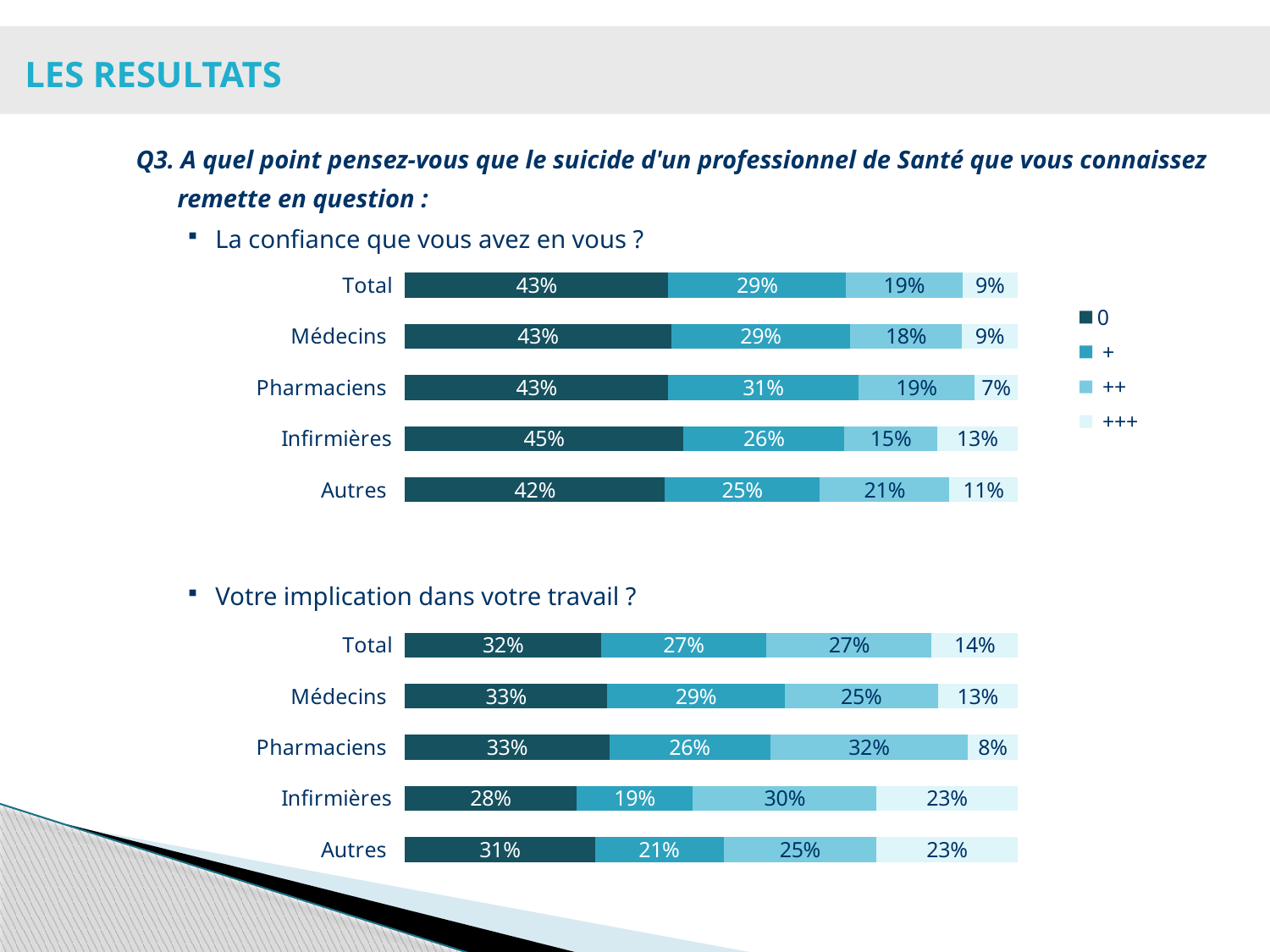
In the bottom chart (Votre implication dans votre travail ?), what is the value of the "++" segment for Pharmaciens? 32% How many categories are shown in the bottom chart (Votre implication dans votre travail ?)? 5 How many series does the legend list? 4 In the top chart (La confiance que vous avez en vous ?), what is the value of the "+++" segment for Pharmaciens? 7% In the top chart (La confiance que vous avez en vous ?), which category has the highest "+++" value? Infirmières In the bottom chart (Votre implication dans votre travail ?), what is the value of the "+" segment for Infirmières? 19% In the bottom chart (Votre implication dans votre travail ?), what is the difference between the "+++" values for Infirmières and Pharmaciens? 15% In the top chart (La confiance que vous avez en vous ?), what is the value of the "0" segment for Infirmières? 45% In the bottom chart (Votre implication dans votre travail ?), which category has the lowest "0" value? Infirmières In the top chart (La confiance que vous avez en vous ?), which is larger: the "+" value for Pharmaciens or for Autres? Pharmaciens What are the four legend entries shown on the slide? 0, +, ++, +++ What type of chart is used for "La confiance que vous avez en vous ?"? Stacked bar chart